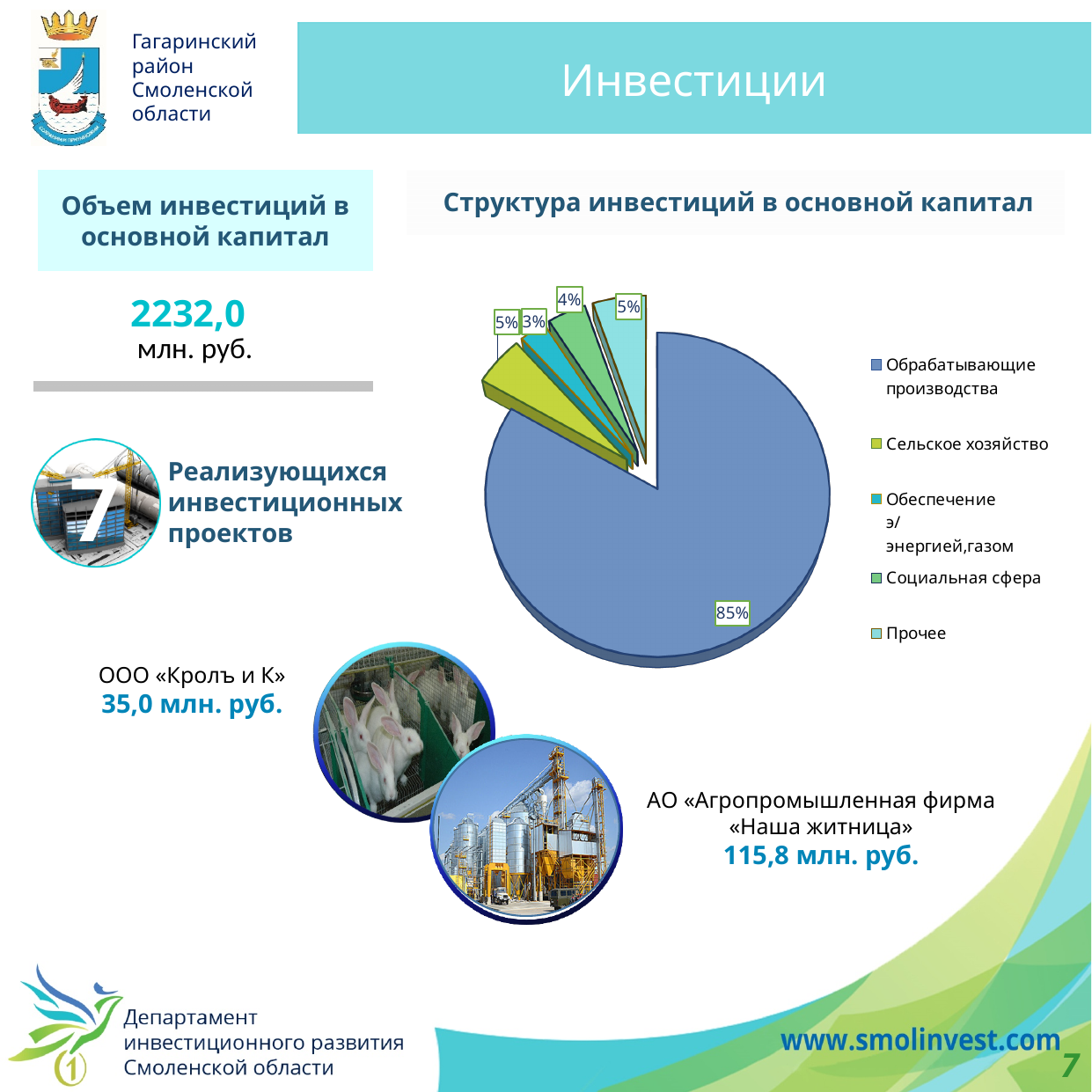
What is the title of the pie chart on the slide? Структура инвестиций в основной капитал Which category has the smallest slice in the pie chart? Обеспечение э/энергией, газом How many categories does the pie chart's legend list? 5 In the pie chart, what share is shown for "Обрабатывающие производства"? 85% Which category has the largest slice in the pie chart? Обрабатывающие производства In the pie chart, what share is shown for "Сельское хозяйство"? 5% In the pie chart, what is the difference in percentage points between "Обрабатывающие производства" and "Сельское хозяйство"? 80 What kind of chart is shown under the title "Структура инвестиций в основной капитал"? pie chart In the pie chart, what share is shown for "Социальная сфера"? 4% In the pie chart, what share is shown for "Прочее"? 5% In the pie chart, which is larger: "Социальная сфера" or "Обеспечение э/энергией, газом"? Социальная сфера In the pie chart, what share is shown for "Обеспечение э/энергией, газом"? 3%